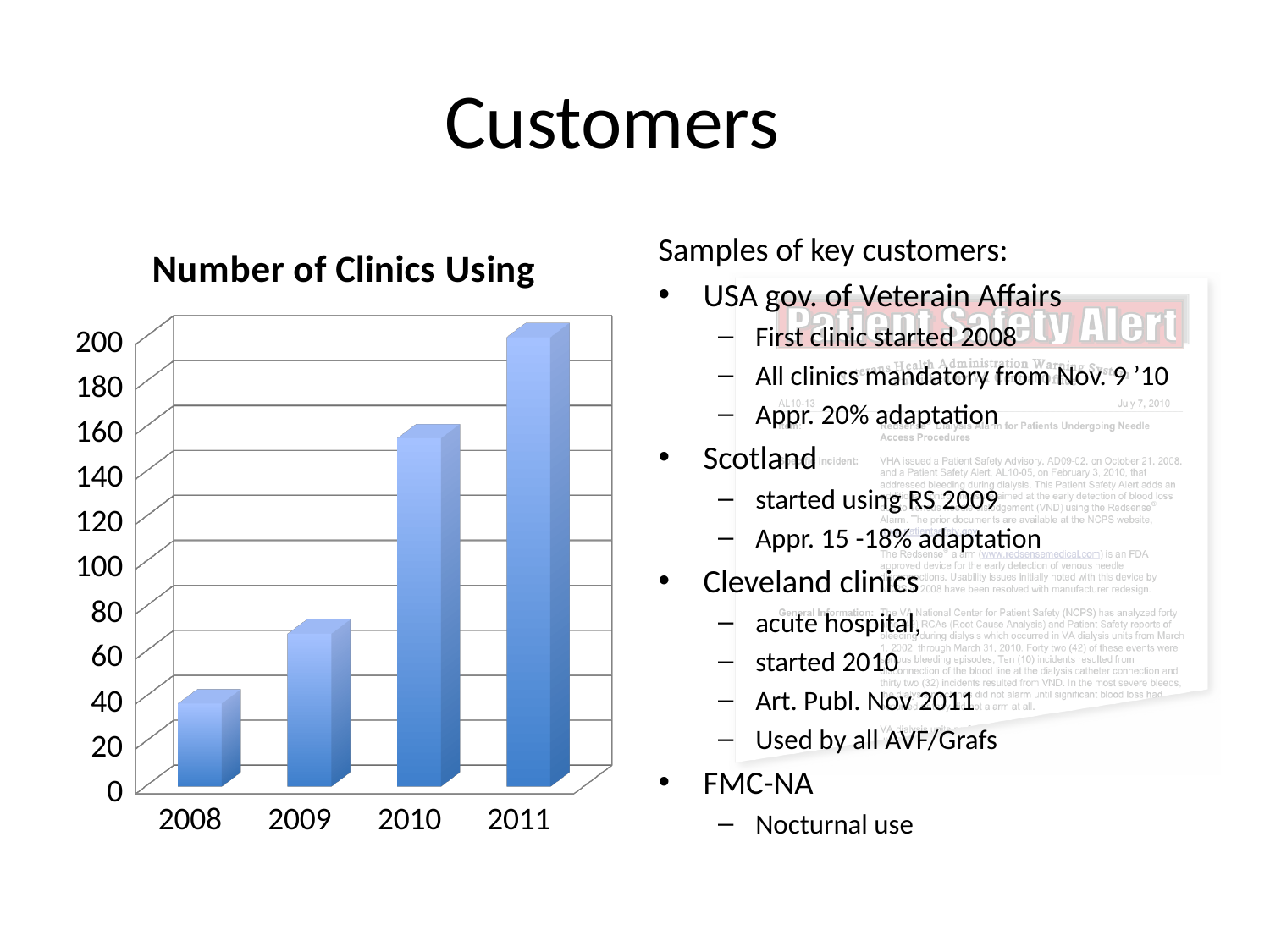
Is the value for 2008 greater or less than 60? less Is the value for 2010 greater or less than 180? less Which year has the lowest number of clinics using? 2008 What is the title of the chart on the slide? Number of Clinics Using Which year has more clinics using, 2009 or 2010? 2010 Is the value for 2009 greater or less than 40? greater Do the values in the chart rise or fall from 2008 to 2011? rise Which year has the highest number of clinics using? 2011 How many years are shown on the x axis of the chart? 4 What kind of chart is used to show the number of clinics using? bar chart